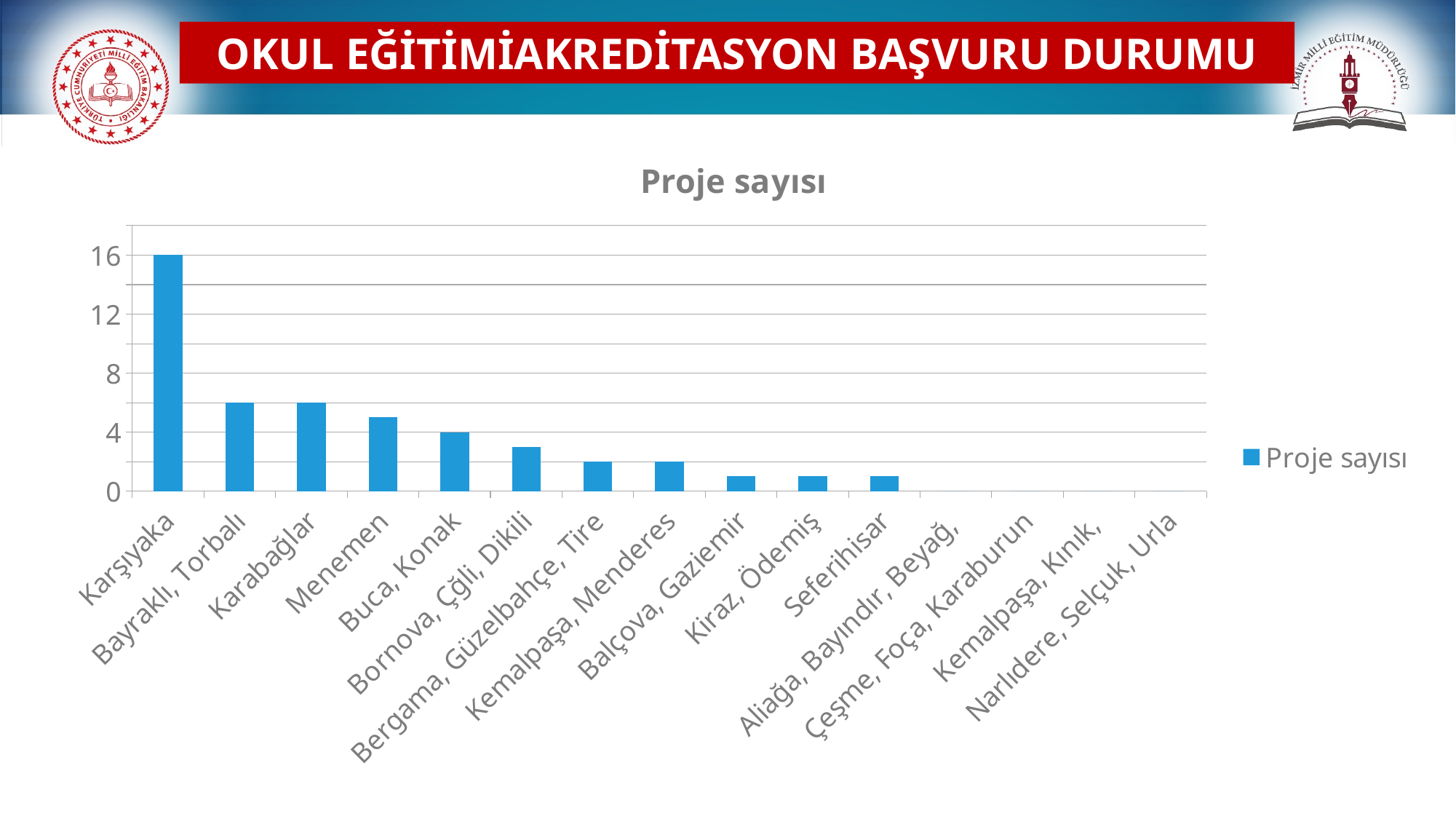
Is the value for Menemen greater or less than 4? greater What kind of chart is shown on the slide? bar chart How many categories are shown on the x axis? 15 Is the value for Bayraklı, Torbalı greater or less than 8? less How many series does the legend list? 1 Which is larger, the value for Menemen or the value for Seferihisar? Menemen What is the title of the chart? Proje sayısı Is the value for Bornova, Çiğli, Dikili greater or less than 4? less Do the values rise or fall from left to right along the x axis? fall What is the value for Buca, Konak? 4 What is the value for Karşıyaka? 16 Which category has the highest value? Karşıyaka